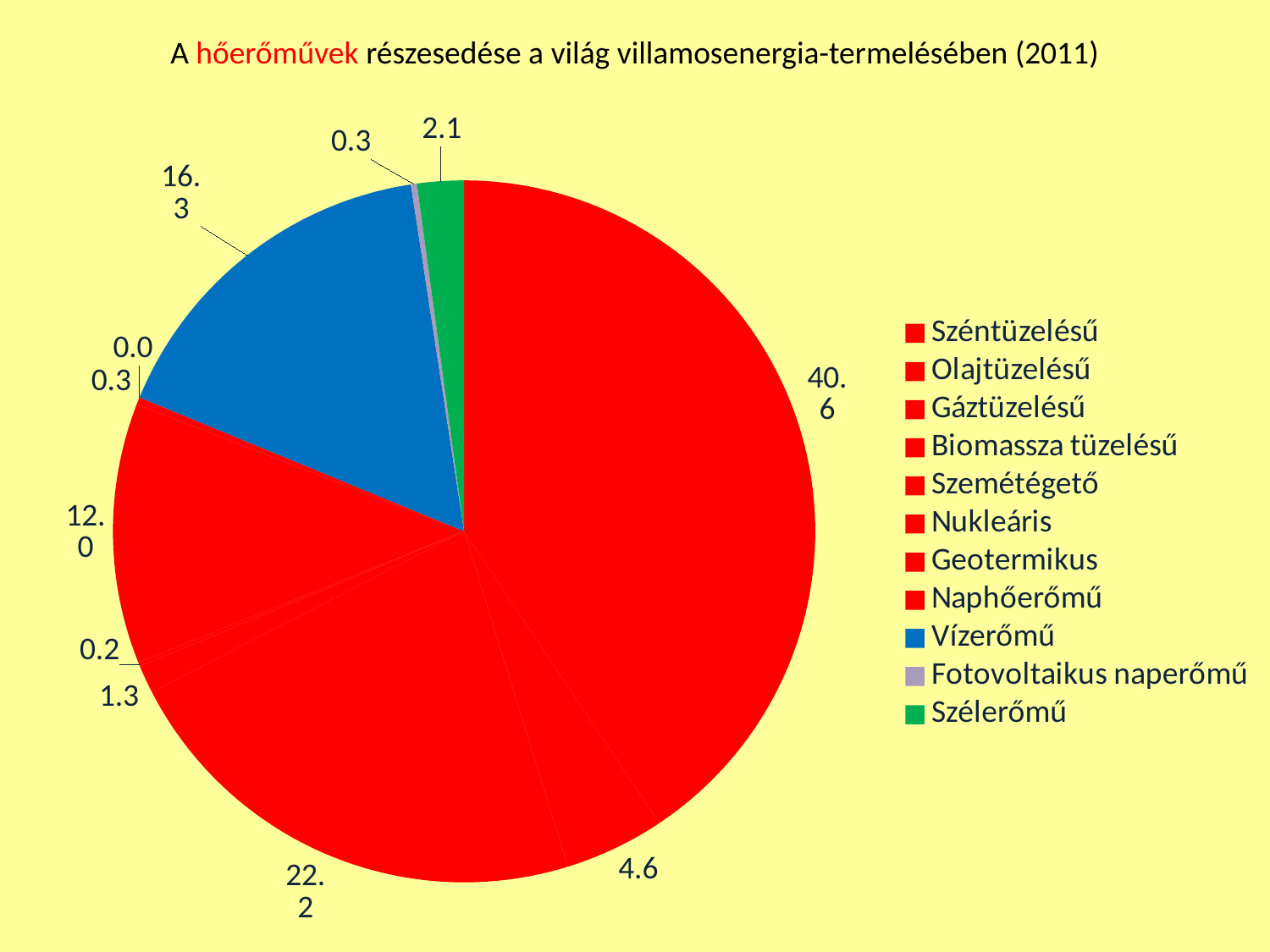
Which category has the largest slice of the pie? Széntüzelésű Which is larger, the slice for Vízerőmű or the slice for Szélerőmű? Vízerőmű What is the value shown for Szélerőmű (the green slice)? 2.1 What kind of chart is shown on the slide? pie chart What colour is the Vízerőmű slice? blue What is the smallest value labelled on the pie chart? 0.0 What is the value shown for Vízerőmű (the blue slice)? 16.3 What is the value shown for Fotovoltaikus naperőmű (the grey slice)? 0.3 How many categories does the legend list? 11 What is the title of the chart? A hőerőművek részesedése a világ villamosenergia-termelésében (2011) What is the largest value labelled on the pie chart? 40.6 What is the difference between the values for Vízerőmű and Szélerőmű? 14.2